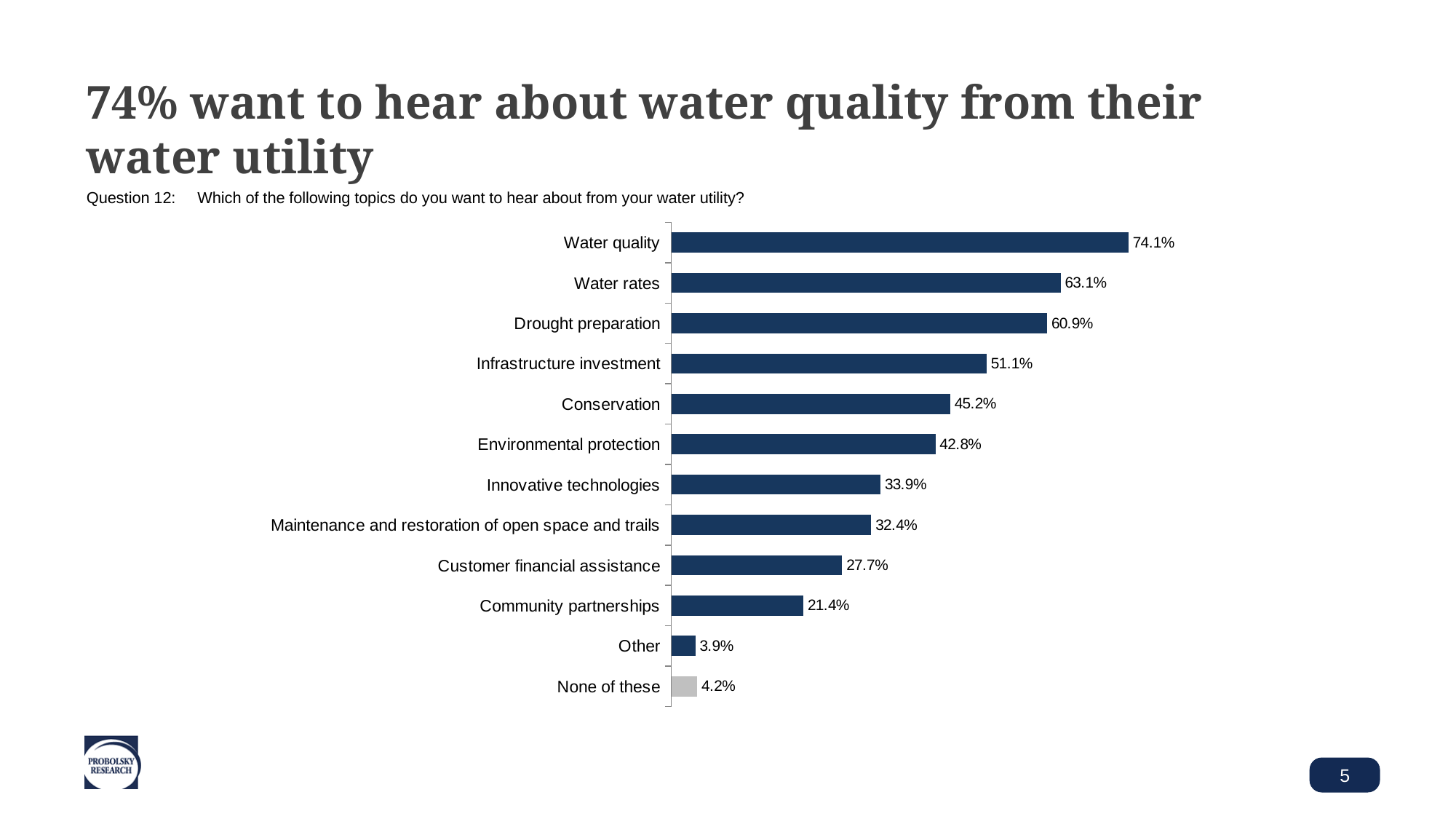
What kind of chart is shown on the slide? Bar chart What is the value shown for Drought preparation? 60.9% What is the value shown for Customer financial assistance? 27.7% What is the difference in percentage points between Water quality and Water rates? 11.0 Which topic has the highest percentage? Water quality Which bar is shown in a different colour (grey) from the others? None of these How many topics (bars) are shown in the chart? 12 Which is larger, the value for Conservation or the value for Environmental protection? Conservation Which topic has the lowest percentage? Other What is the difference in percentage points between Innovative technologies and Maintenance and restoration of open space and trails? 1.5 What percentage of respondents want to hear about water quality from their water utility? 74.1% What is the value shown for Community partnerships? 21.4%